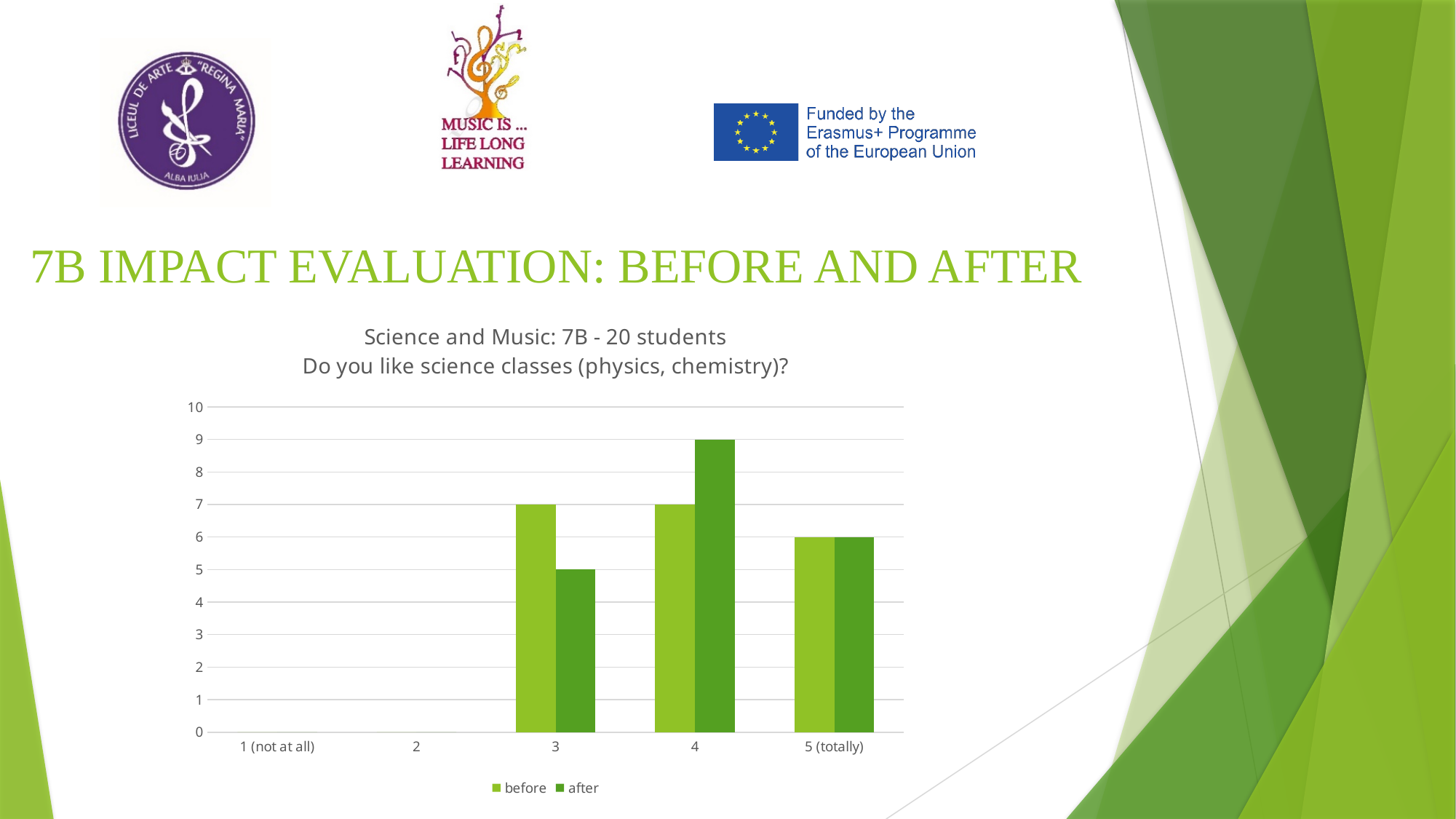
What question is shown in the chart title? Do you like science classes (physics, chemistry)? What is the 'before' value for category 5 (totally)? 6 What is the 'after' value for category 3? 5 How many series does the legend list? 2 Is the 'after' value for category 4 greater or less than 8? greater What is the difference between the 'after' and 'before' values for category 4? 2 For category 4, which is larger, the 'before' value or the 'after' value? after What kind of chart is shown on the slide? bar chart Which category has the highest 'after' value? 4 How many categories are shown on the x axis? 5 What is the 'before' value for category 3? 7 What is the 'after' value for category 4? 9